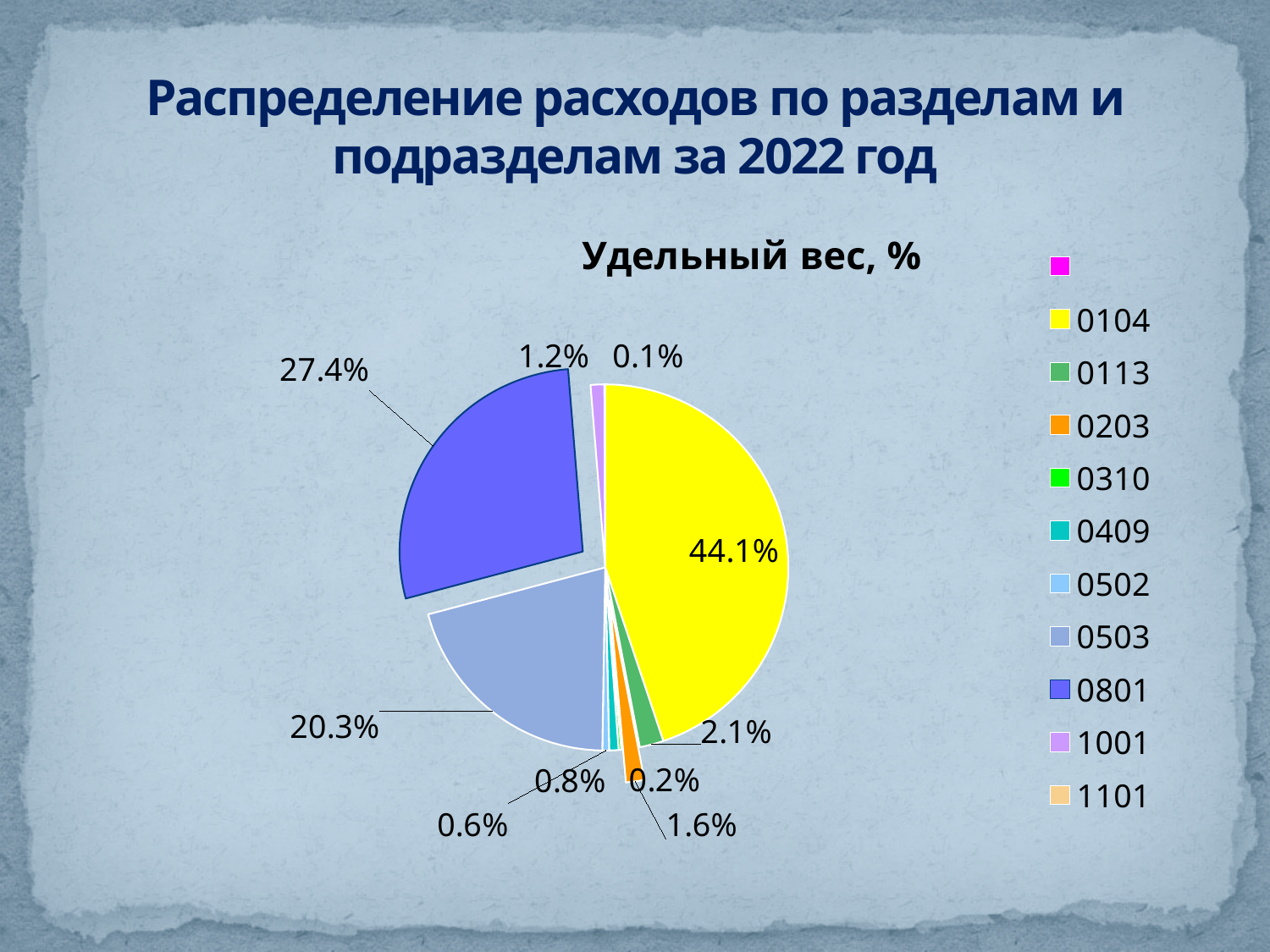
What is the difference in percentage points between the slices for 0104 and 0801? 16.7 What share of the pie does category 0113 have? 2.1% What type of chart is shown on the slide? pie chart What is the title of the chart? Удельный вес, % What share of the pie does category 0801 have? 27.4% What share of the pie does category 0409 have? 0.8% What share of the pie does category 1001 have? 1.2% What share of the pie does category 0104 have? 44.1% Which is larger, the slice for 0801 or the slice for 0503? 0801 What colour is the slice for category 0104? yellow What share of the pie does category 0503 have? 20.3% Which category has the largest slice of the pie? 0104